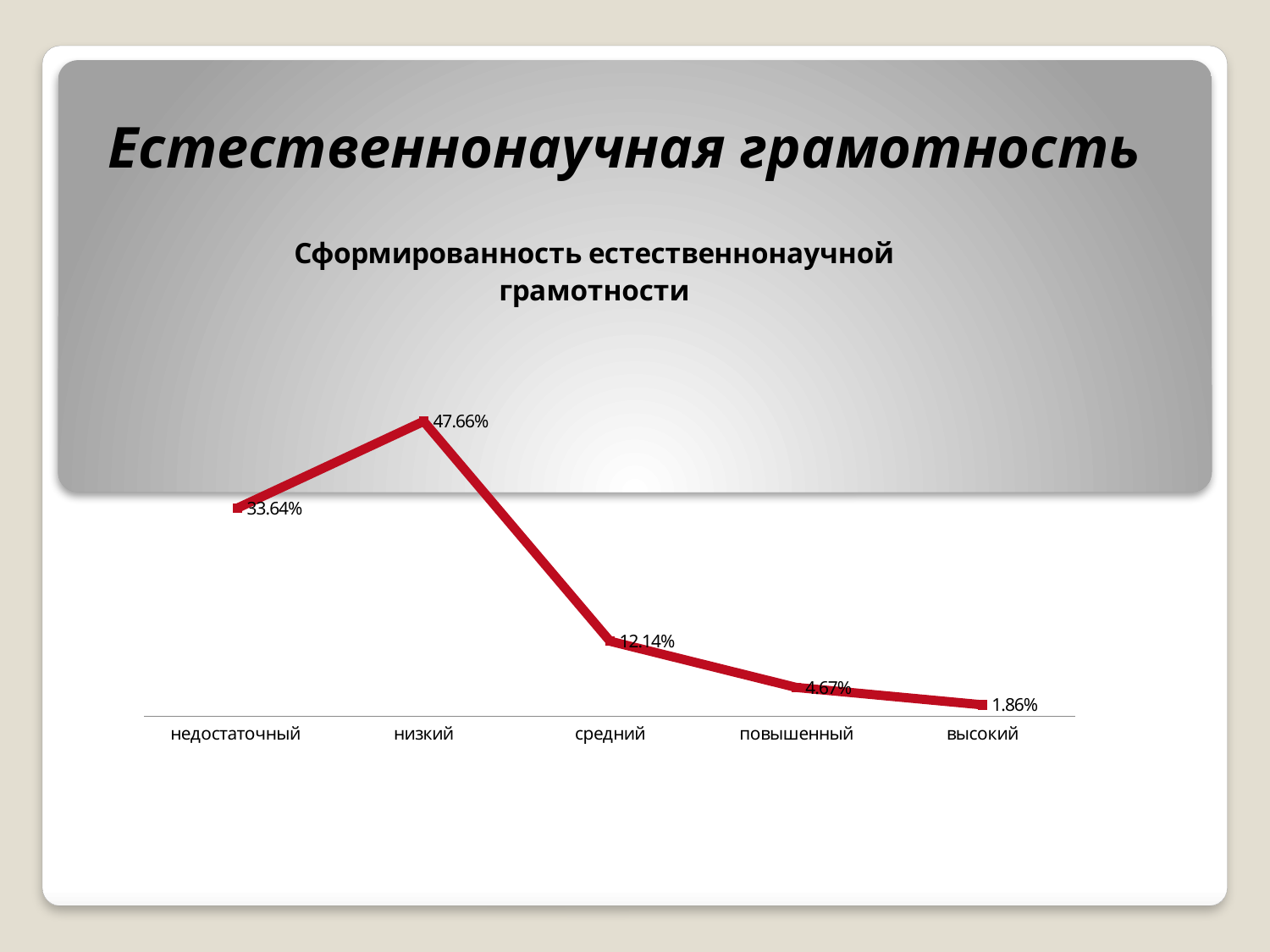
Which category has the highest value? низкий How many categories are shown on the x axis? 5 Which category has the lowest value? высокий What is the title of the chart? Сформированность естественнонаучной грамотности Which is larger, the value for "средний" or the value for "повышенный"? средний Do the values rise or fall from "низкий" to "высокий"? fall What is the value for the category "высокий"? 1.86% What is the value for the category "средний"? 12.14% What type of chart is shown on the slide? line chart What is the value for the category "недостаточный"? 33.64% What is the value for the category "низкий"? 47.66% What is the difference between the values for "низкий" and "недостаточный"? 14.02%